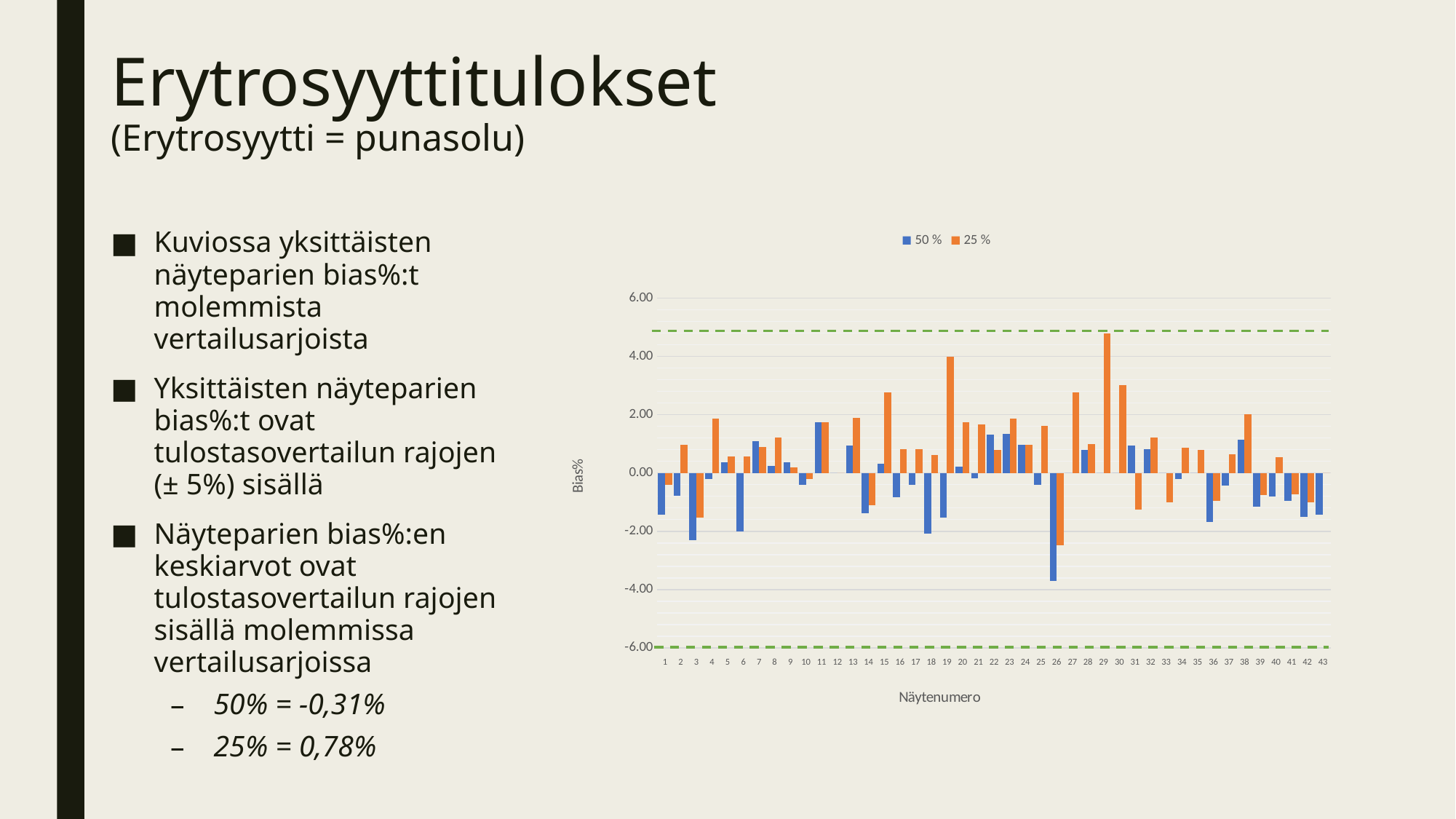
What kind of chart is shown on the slide? bar chart Is the 25 % value for sample 29 greater or less than 4.00? greater Which sample number has the highest value in the 25 % series? 29 Which sample number has the lowest value in the 50 % series? 26 In the 25 % series, which is larger: the value for sample 29 or the value for sample 19? sample 29 Is the 50 % value for sample 26 greater or less than -2.00? less What is the title of the x axis of the chart? Näytenumero What are the two series named in the chart legend? 50 % and 25 % How many sample numbers (Näytenumero) are shown on the x axis of the chart? 43 In the 50 % series, which is larger: the value for sample 11 or the value for sample 1? sample 11 Is the 25 % value for sample 15 greater or less than 2.00? greater How many series does the chart legend list? 2